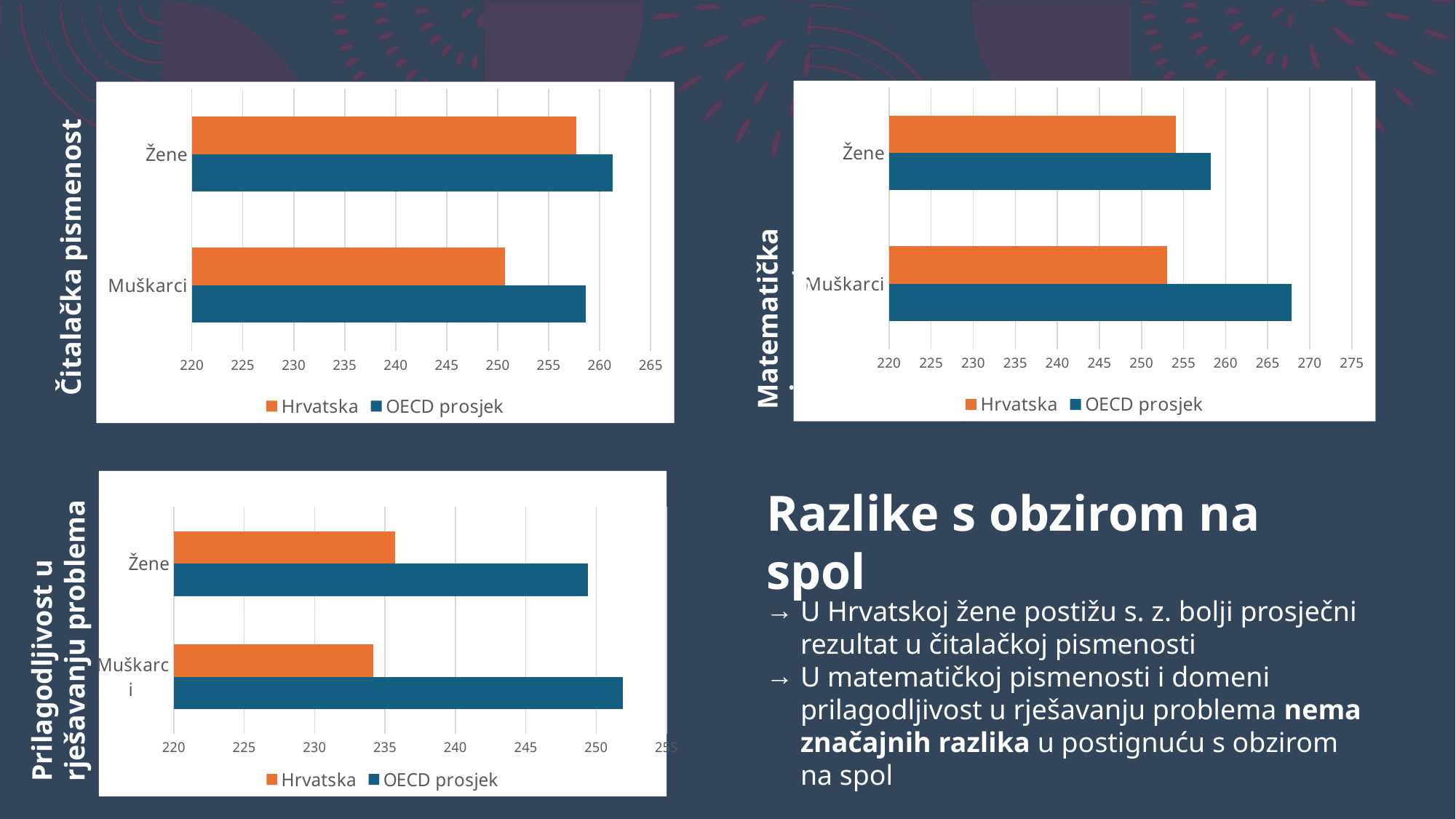
On the 'Matematička' chart, is the Hrvatska value for Muškarci greater or less than 255? less On the 'Čitalačka pismenost' chart, is the OECD prosjek value for Muškarci greater or less than 255? greater On the 'Matematička' chart, how many categories are shown on the vertical axis? 2 On the 'Čitalačka pismenost' chart, how many series does the legend list? 2 On the 'Čitalačka pismenost' chart, which Hrvatska value is larger, Žene or Muškarci? Žene On the 'Prilagodljivost u rješavanju problema' chart, is the Hrvatska value for Žene greater or less than 240? less On the 'Čitalačka pismenost' chart, what kind of chart is shown? bar chart On the 'Prilagodljivost u rješavanju problema' chart, what colour represents the Hrvatska series in the legend? orange On the 'Matematička' chart, which OECD prosjek value is larger, Žene or Muškarci? Muškarci